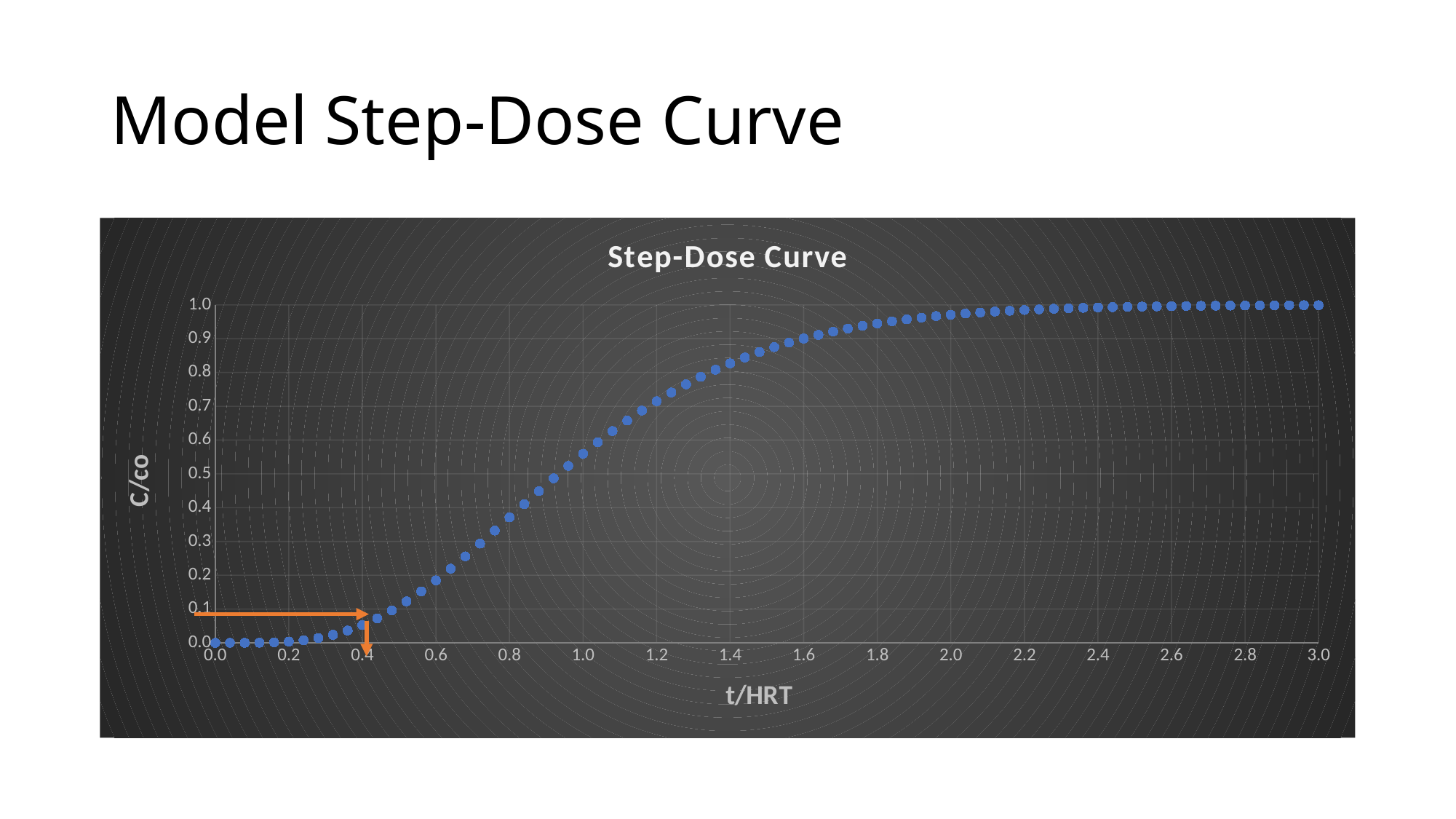
Is the value of C/co at t/HRT = 0.8 greater or less than 0.3? greater Do the C/co values rise or fall as t/HRT increases? rise What kind of chart is shown on the slide? scatter chart Which is larger, the C/co value at t/HRT = 2.0 or at t/HRT = 0.4? t/HRT = 2.0 What is the value of C/co at t/HRT = 0.0? 0.0 Is the value of C/co at t/HRT = 0.2 greater or less than 0.1? less What is the label of the x axis? t/HRT Is the value of C/co at t/HRT = 2.0 greater or less than 0.9? greater What is the title of the chart? Step-Dose Curve